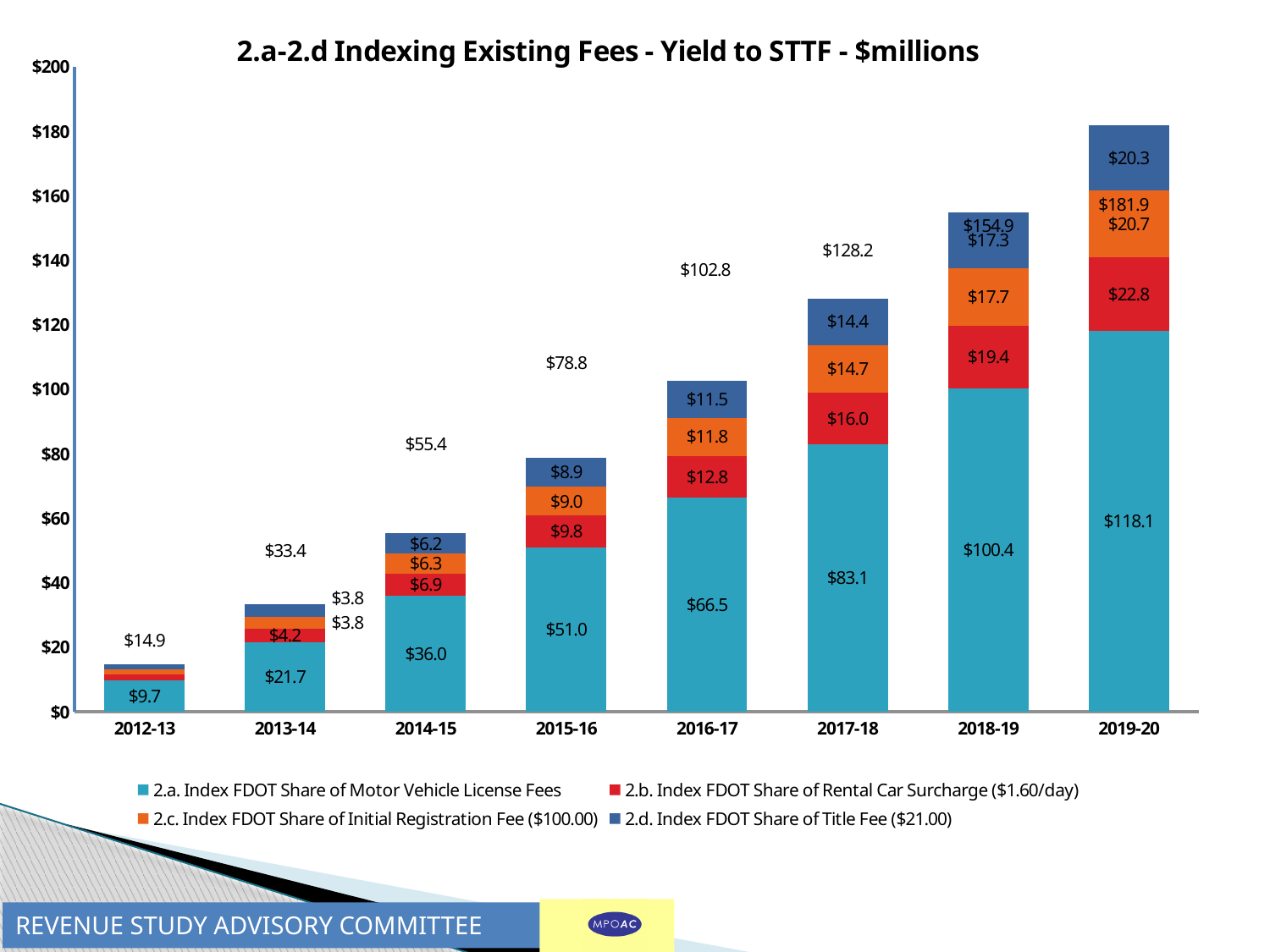
Which year has the highest total yield? 2019-20 What is the difference between the Motor Vehicle License Fees value in 2018-19 and in 2017-18? $17.3 What is the value for 2.a. Index FDOT Share of Motor Vehicle License Fees in 2019-20? $118.1 Which year has the lowest total yield? 2012-13 What is the total yield shown for 2018-19? $154.9 What is the value for 2.c. Index FDOT Share of Initial Registration Fee in 2015-16? $9.0 Do the total yields rise or fall from 2012-13 to 2019-20? rise Which is larger in 2014-15: the Rental Car Surcharge value or the Title Fee value? Rental Car Surcharge How many fiscal years are shown on the x axis? 8 What is the value for 2.b. Index FDOT Share of Rental Car Surcharge in 2017-18? $16.0 What is the value for 2.d. Index FDOT Share of Title Fee in 2016-17? $11.5 How many series does the legend list? 4